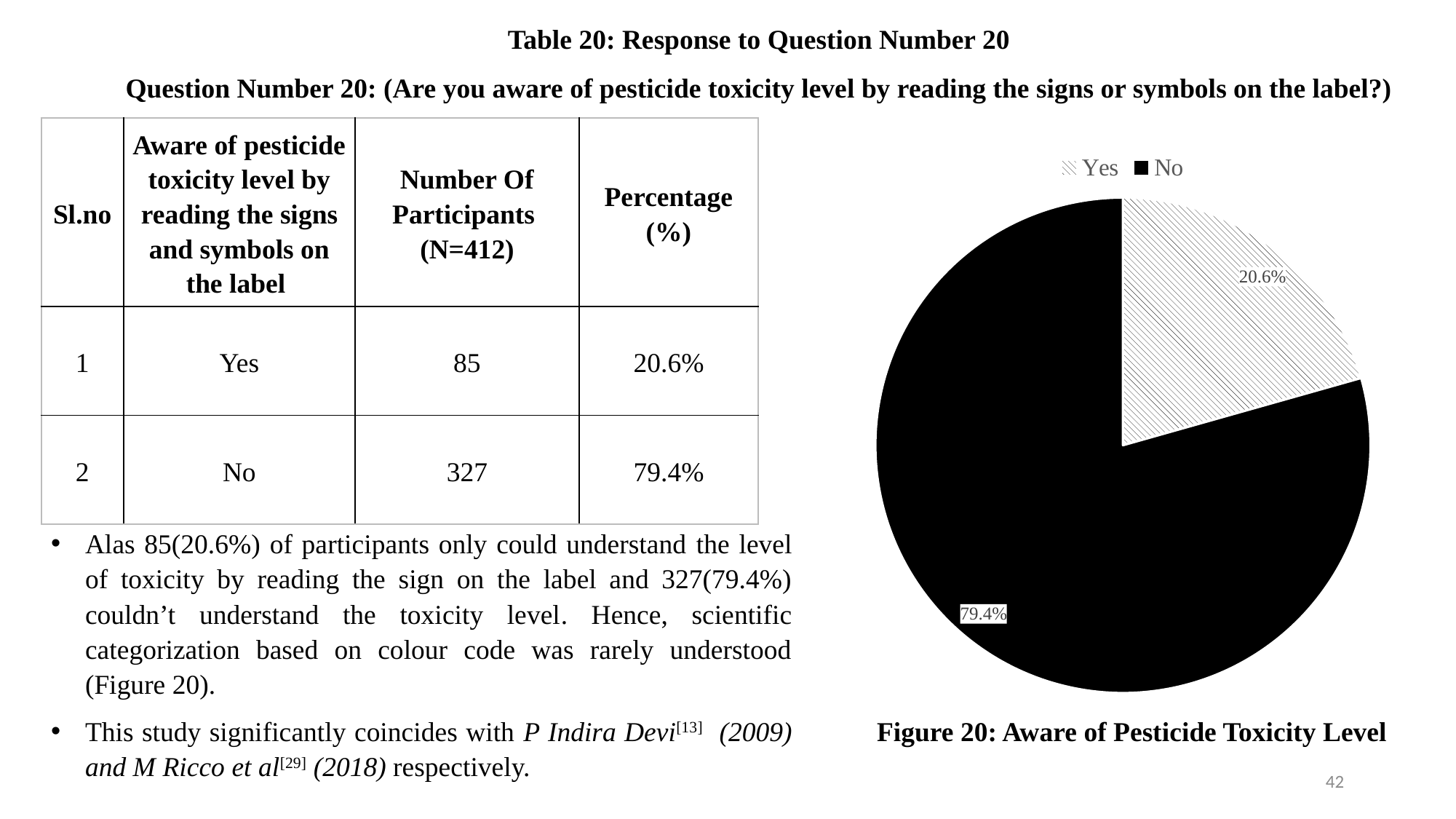
Is the Yes slice of the pie chart greater or less than 25%? less Which slice of the pie chart is the largest? No In the pie chart, which is larger, the Yes slice or the No slice? No Which slice of the pie chart is the smallest? Yes What kind of chart is shown in Figure 20? pie chart In the pie chart, what percentage is shown for the No slice? 79.4% In the pie chart, what percentage is shown for the Yes slice? 20.6% In the pie chart, which legend entry is shown with a solid black fill? No What is the title of the figure containing the pie chart? Figure 20: Aware of Pesticide Toxicity Level How many entries does the legend of the pie chart list? 2 How many slices does the pie chart have? 2 What is the difference in percentage points between the No slice and the Yes slice in the pie chart? 58.8